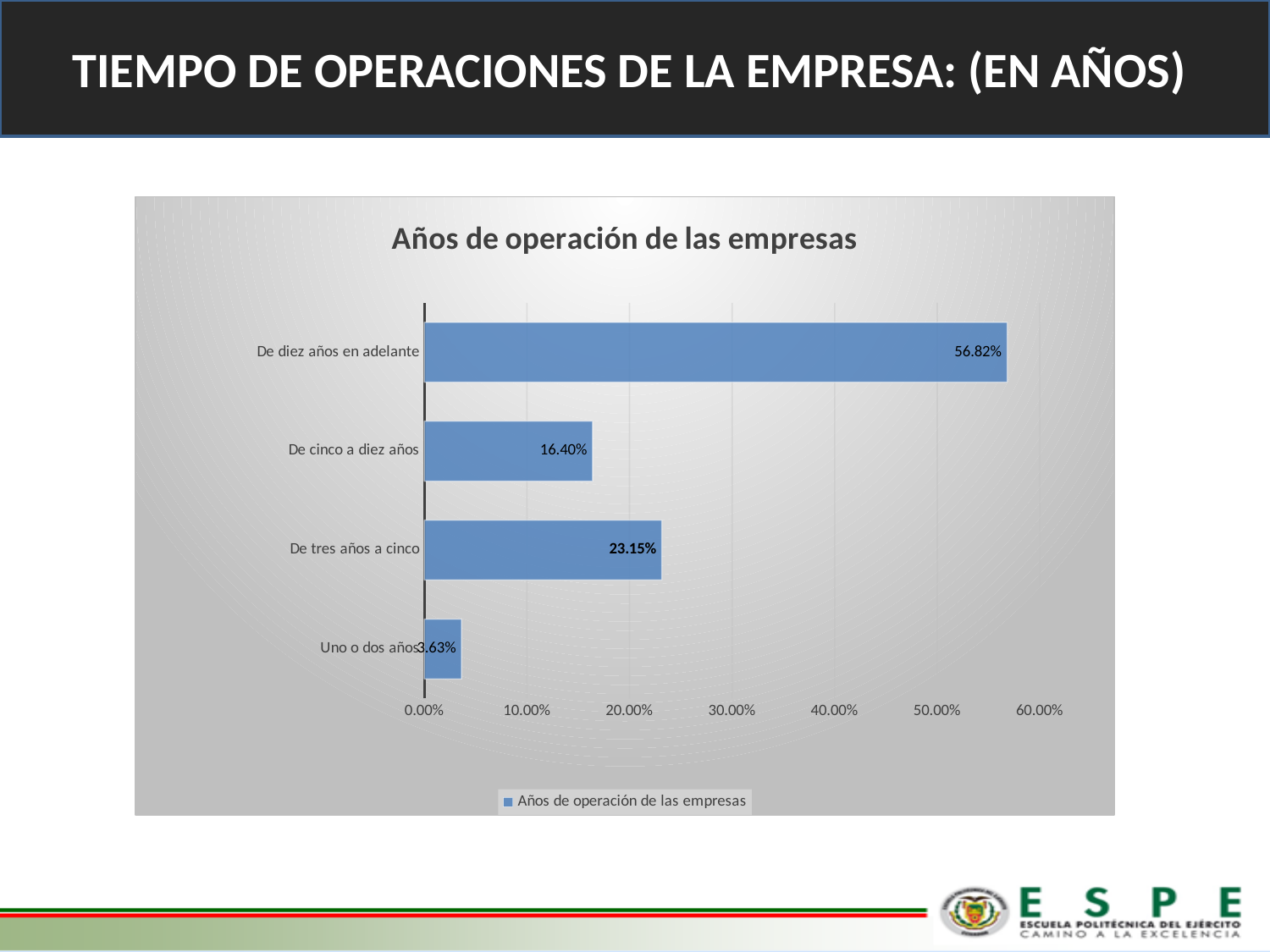
What kind of chart is shown on the slide? bar chart Which category has the lowest value? Uno o dos años What is the difference between the values for "De diez años en adelante" and "De tres años a cinco"? 33.67% Which is larger, the value for "De tres años a cinco" or "De cinco a diez años"? De tres años a cinco What is the value for "De cinco a diez años"? 16.40% Is the value for "De diez años en adelante" greater or less than 50.00%? greater How many categories are shown in the chart? 4 Which category has the highest value? De diez años en adelante What is the value for "Uno o dos años"? 3.63% What is the value for "De diez años en adelante"? 56.82% What is the title of the chart? Años de operación de las empresas What is the value for "De tres años a cinco"? 23.15%